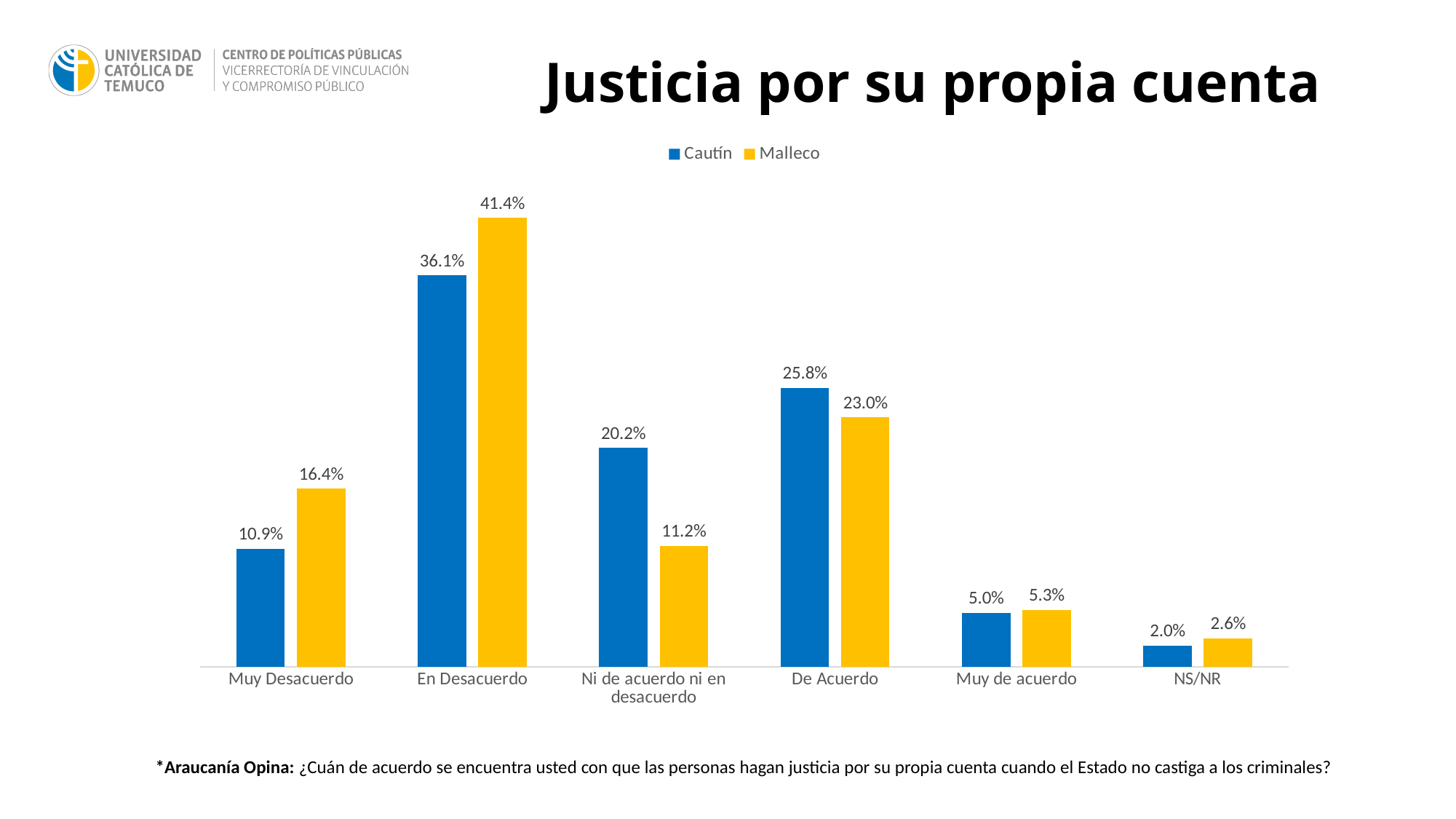
What is the title of the chart? Justicia por su propia cuenta What kind of chart is shown on the slide? Bar chart What is the value for Malleco in the Muy Desacuerdo category? 16.4% Which category has the lowest value for Cautín? NS/NR How many categories are shown on the x axis? 6 What is the difference between the Malleco and Cautín values in the En Desacuerdo category? 5.3% Which is larger in the De Acuerdo category, the Cautín value or the Malleco value? Cautín What is the value for Malleco in the NS/NR category? 2.6% What is the difference between the Cautín and Malleco values in the Ni de acuerdo ni en desacuerdo category? 9.0% What is the value for Cautín in the En Desacuerdo category? 36.1% How many series does the legend list? 2 Which category has the highest value for Malleco? En Desacuerdo